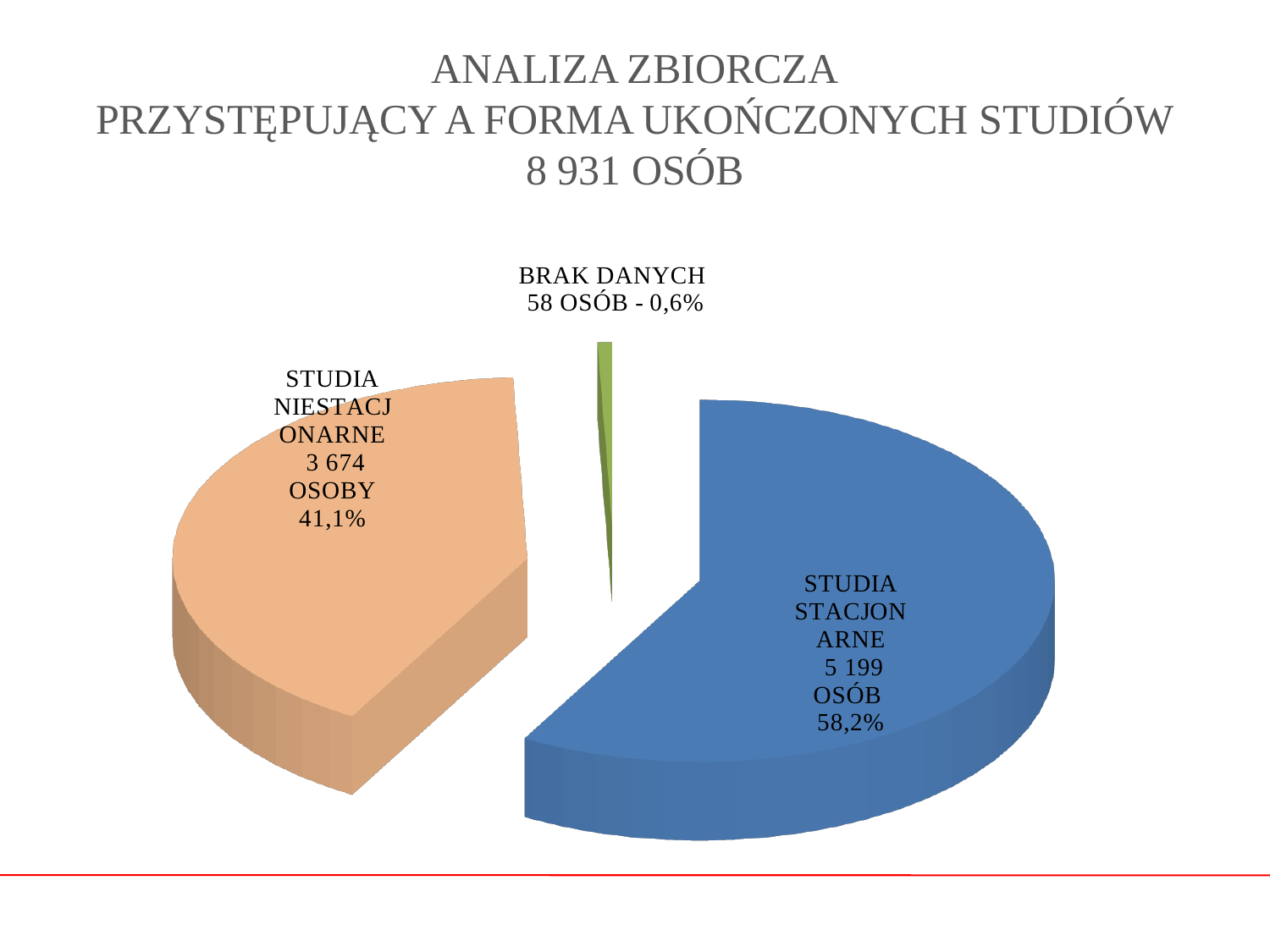
Which category has the largest slice? STUDIA STACJONARNE How many slices does the pie chart have? 3 What kind of chart is shown on the slide? pie chart How many people are in the BRAK DANYCH slice? 58 How many people are in the STUDIA STACJONARNE slice? 5 199 What share of the pie does STUDIA NIESTACJONARNE represent? 41,1% What share of the pie does BRAK DANYCH represent? 0,6% What is the difference in number of people between STUDIA STACJONARNE and STUDIA NIESTACJONARNE? 1 525 What share of the pie does STUDIA STACJONARNE represent? 58,2% How many people are in the STUDIA NIESTACJONARNE slice? 3 674 Which category has the smallest slice? BRAK DANYCH What total number of people is stated in the chart title? 8 931